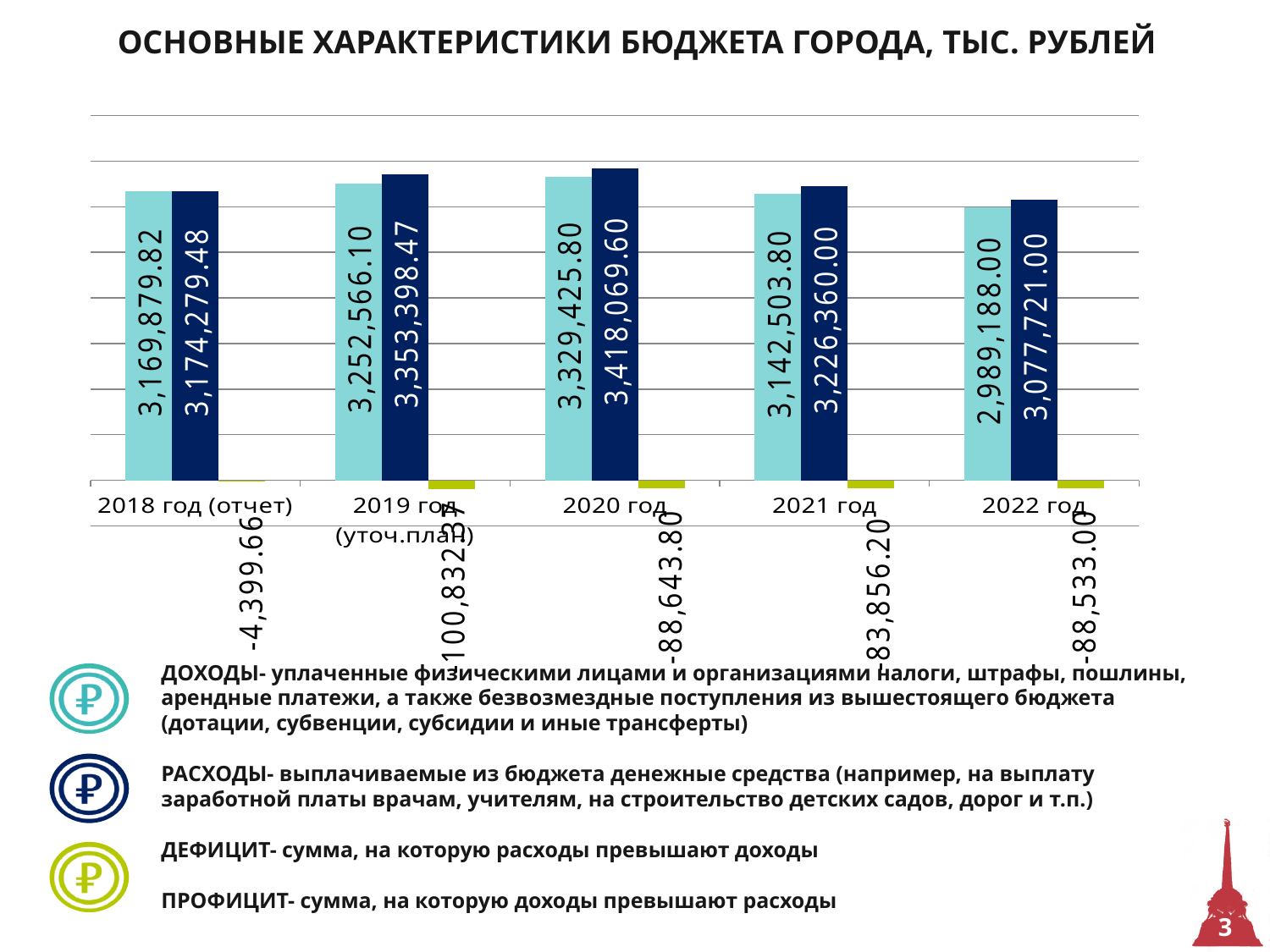
What is the value of the dark blue bar (расходы) for 2020 год? 3,418,069.60 Which is larger: the light blue bar for 2019 год (уточ.план) or the light blue bar for 2021 год? 2019 год (уточ.план) By how much does the dark blue bar exceed the light blue bar for 2018 год (отчет)? 4,399.66 How many year categories are shown on the x axis? 5 What is the value of the dark blue bar (расходы) for 2021 год? 3,226,360.00 What is the value of the light blue bar (доходы) for 2018 год (отчет)? 3,169,879.82 What type of chart is shown on the slide? Bar chart By how much does the dark blue bar exceed the light blue bar for 2022 год? 88,533.00 Do the light blue bars (доходы) rise or fall from 2020 год to 2022 год? Fall What is the value of the green bar (дефицит) for 2022 год? -88,533.00 Which year has the highest value for the dark blue bar (расходы)? 2020 год Which year has the lowest value for the light blue bar (доходы)? 2022 год